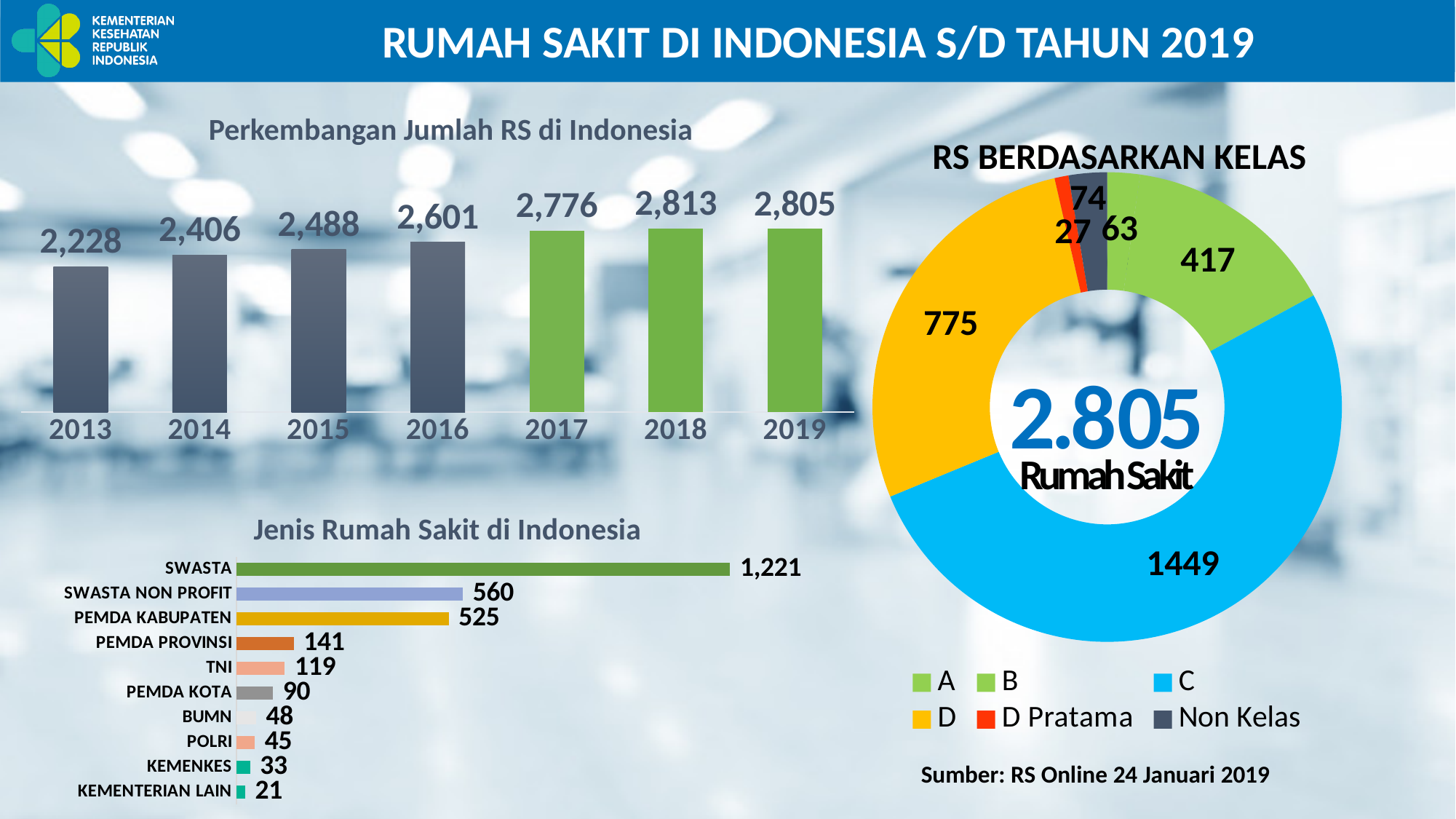
In the 'Jenis Rumah Sakit di Indonesia' chart, which category has the highest value? SWASTA In the 'RS BERDASARKAN KELAS' chart, which of class C or class D has the larger value? C In the 'Perkembangan Jumlah RS di Indonesia' chart, which year has the highest value? 2018 In the 'Jenis Rumah Sakit di Indonesia' chart, how many categories are shown? 10 In the 'Perkembangan Jumlah RS di Indonesia' chart, what is the value for 2016? 2,601 In the 'Jenis Rumah Sakit di Indonesia' chart, what is the value for PEMDA PROVINSI? 141 In the 'RS BERDASARKAN KELAS' chart, what is the value for class C? 1449 In the 'Jenis Rumah Sakit di Indonesia' chart, what is the difference between SWASTA NON PROFIT and PEMDA KABUPATEN? 35 In the 'Perkembangan Jumlah RS di Indonesia' chart, which year has the lowest value? 2013 In the 'Perkembangan Jumlah RS di Indonesia' chart, what is the difference between the 2018 and 2019 values? 8 In the 'Perkembangan Jumlah RS di Indonesia' chart, how many years are shown? 7 What kind of chart is 'Perkembangan Jumlah RS di Indonesia'? Bar chart